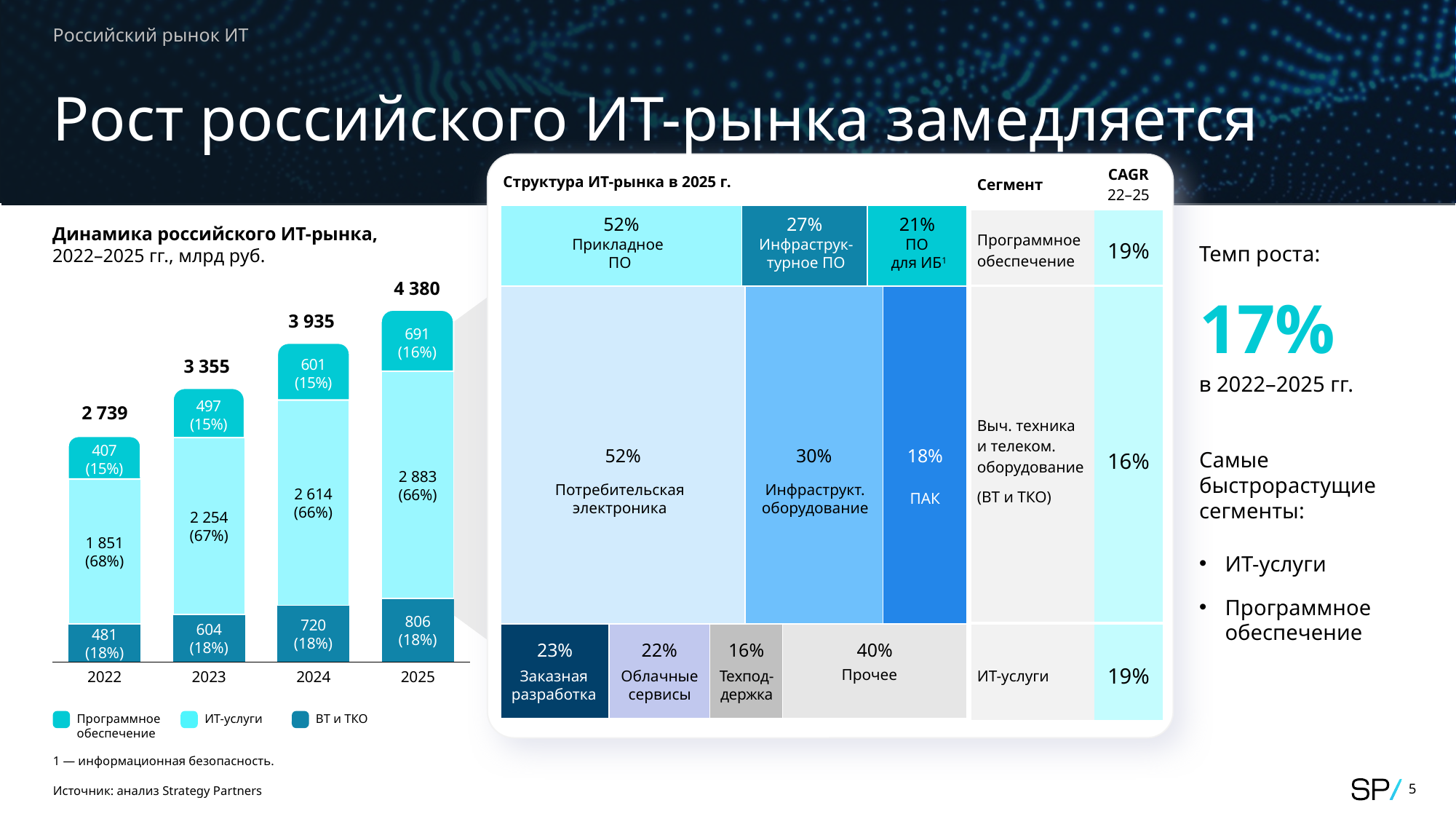
In the chart 'Динамика российского ИТ-рынка', which is larger in 2023: Программное обеспечение or ВТ и ТКО? ВТ и ТКО How many series does the legend of the chart 'Динамика российского ИТ-рынка' list? 3 In the chart 'Динамика российского ИТ-рынка', what is the value of ВТ и ТКО in 2024? 720 What kind of chart is 'Динамика российского ИТ-рынка'? Stacked bar chart In the chart 'Динамика российского ИТ-рынка', what is the total value for 2025? 4 380 In the chart 'Динамика российского ИТ-рынка', which year has the lowest total? 2022 In the chart 'Динамика российского ИТ-рынка', what is the value of Программное обеспечение in 2022? 407 In the chart 'Динамика российского ИТ-рынка', do the totals rise or fall from 2022 to 2025? Rise In the chart 'Динамика российского ИТ-рынка', what is the value of ИТ-услуги in 2023? 2 254 In the chart 'Динамика российского ИТ-рынка', what is the difference between the totals for 2025 and 2024? 445 In the chart 'Структура ИТ-рынка в 2025 г.', what share does Прикладное ПО have? 52% In the chart 'Динамика российского ИТ-рынка', which year has the highest total? 2025